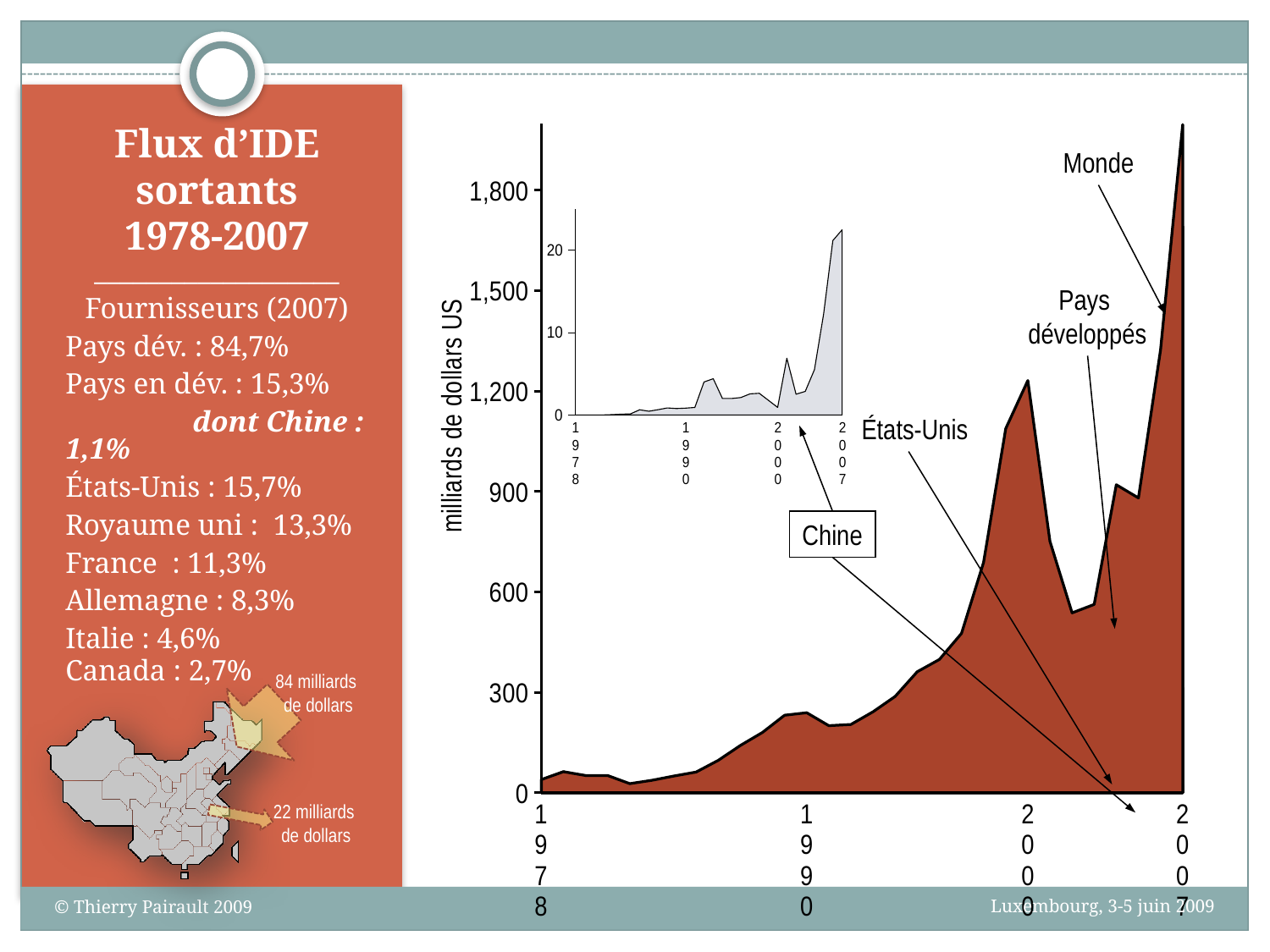
What kind of chart is the main chart on the slide? area chart In the main chart, which is larger, the value for 1990 or the value for 2000? 2000 In the inset chart for Chine, is the value for 1990 greater or less than 10? less What is the label on the vertical axis of the main chart? milliards de dollars US In the main chart, do the values overall rise or fall from 1978 to 2007? rise What is the title of the small inset chart inside the main chart? Chine In the inset chart for Chine, is the value for 2007 greater or less than 20? greater In the main chart, is the value for 1990 greater or less than 300? less In the main chart, which year shown on the x axis has the highest value? 2007